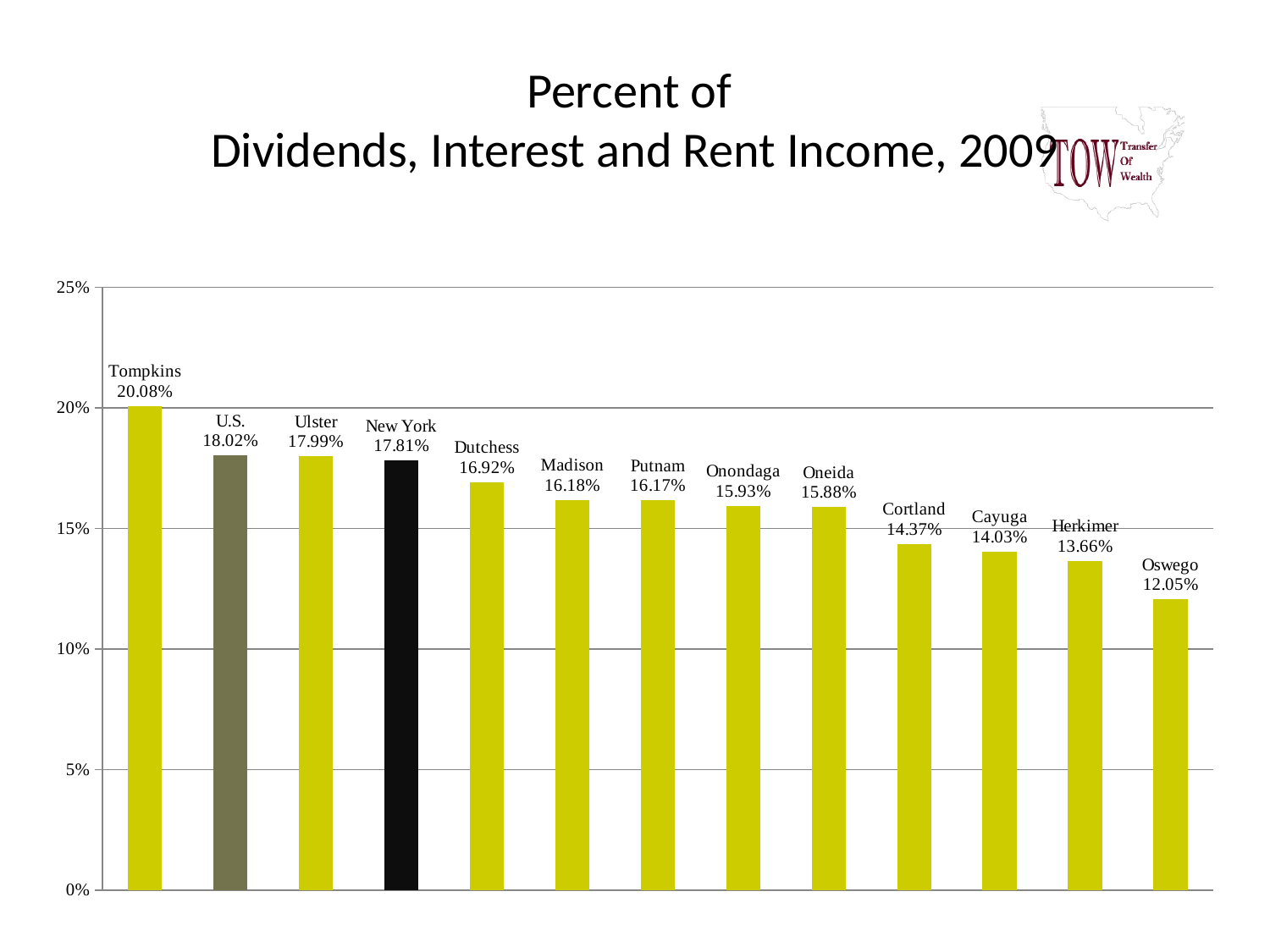
Do the values rise or fall from left to right along the x axis? fall What is the difference between the values for U.S. and New York? 0.21% What is the value for New York? 17.81% What kind of chart is shown on the slide? bar chart What is the difference between the values for Tompkins and Oswego? 8.03% What is the value for Tompkins? 20.08% What is the value for Oneida? 15.88% Is the value for Herkimer greater or less than 15%? less Which category has the lowest value? Oswego How many bars are shown in the chart? 13 Which is larger, the value for Dutchess or the value for Cortland? Dutchess Which category has the highest value? Tompkins